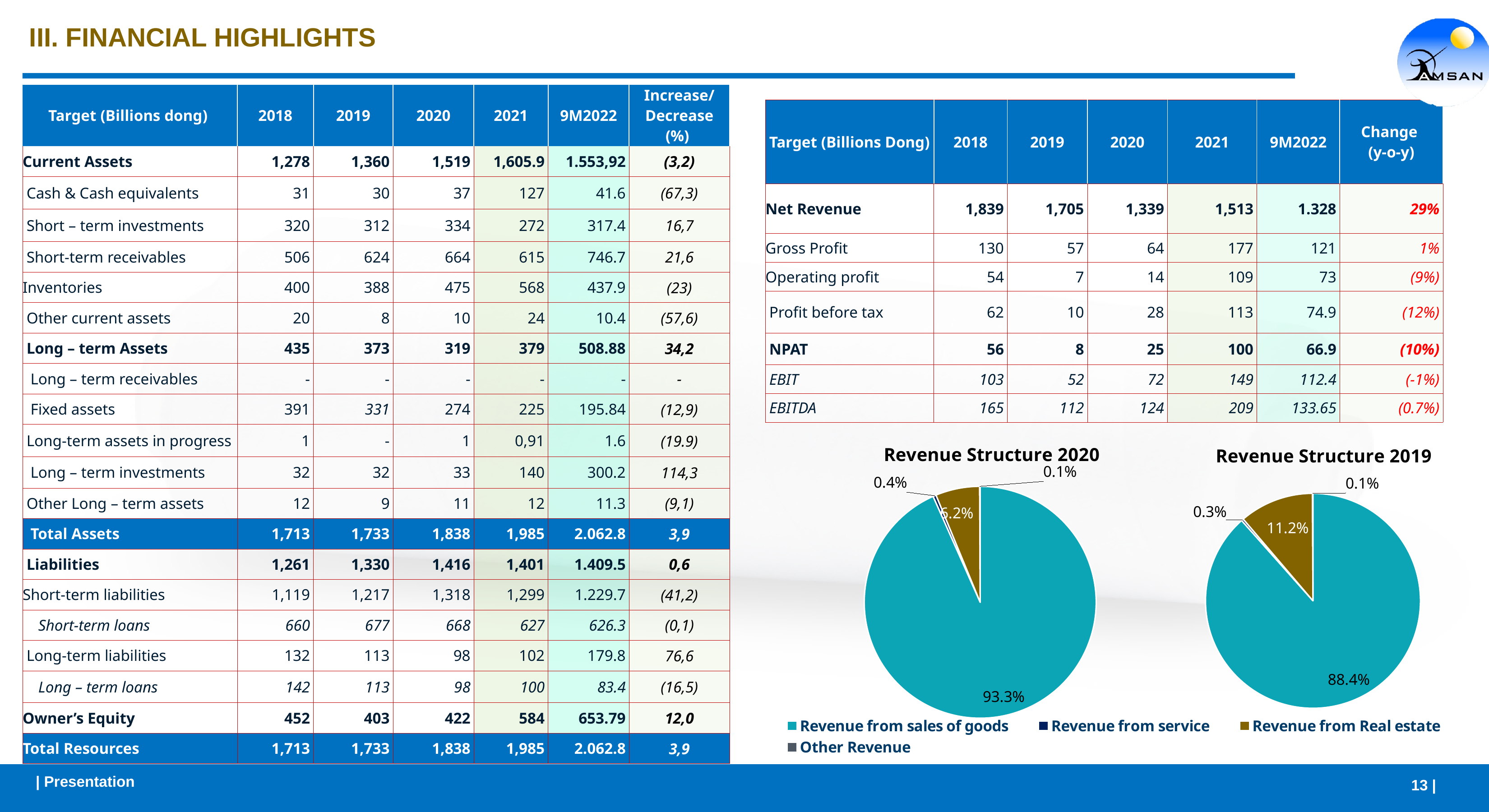
In the Revenue Structure 2020 pie chart, what share is Revenue from Real estate? 6.2% In the Revenue Structure 2020 pie chart, which category has the largest slice? Revenue from sales of goods What is the difference between the Revenue from sales of goods share in the Revenue Structure 2020 chart and in the Revenue Structure 2019 chart? 4.9% What type of chart is Revenue Structure 2020? Pie chart In the revenue structure pie charts, which category is shown in teal? Revenue from sales of goods What is the smallest share shown in the Revenue Structure 2020 pie chart? 0.1% In the Revenue Structure 2020 pie chart, what share is Revenue from sales of goods? 93.3% How many categories does the legend of the revenue structure pie charts list? 4 Is the share of Revenue from Real estate larger in the Revenue Structure 2020 chart or the Revenue Structure 2019 chart? Revenue Structure 2019 In the Revenue Structure 2019 pie chart, what share is Revenue from sales of goods? 88.4% In the Revenue Structure 2019 pie chart, which category has the largest slice? Revenue from sales of goods